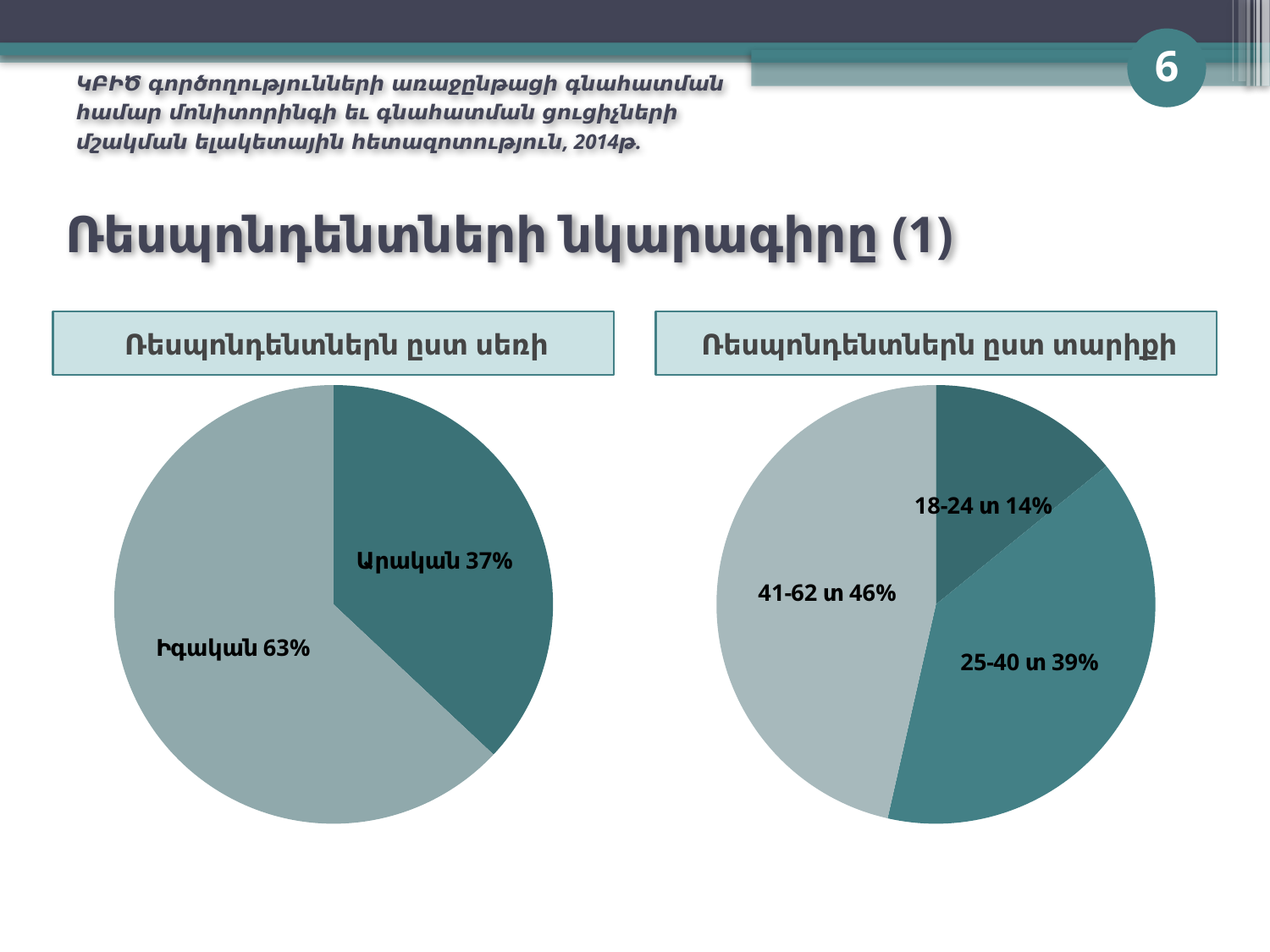
In the right chart (Ռեսպոնդենտներն ըստ տարիքի), which age group has the smallest share? 18-24 տ In the right chart (Ռեսպոնդենտներն ըստ տարիքի), what share is labelled for 18-24 տ? 14% In the left chart (Ռեսպոնդենտներն ըստ սեռի), what share is labelled for Իգական? 63% In the right chart (Ռեսպոնդենտներն ըստ տարիքի), which is larger: the share for 25-40 տ or for 41-62 տ? 41-62 տ In the left chart (Ռեսպոնդենտներն ըստ սեռի), which slice is the largest? Իգական What kind of chart is the left chart titled "Ռեսպոնդենտներն ըստ սեռի"? Pie chart In the right chart (Ռեսպոնդենտներն ըստ տարիքի), which age group has the largest share? 41-62 տ In the left chart (Ռեսպոնդենտներն ըստ սեռի), what share is labelled for Արական? 37% In the right chart (Ռեսպոնդենտներն ըստ տարիքի), what share is labelled for 25-40 տ? 39% In the left chart (Ռեսպոնդենտներն ըստ սեռի), what is the difference between the Իգական and Արական shares? 26% How many slices does the right pie chart (Ռեսպոնդենտներն ըստ տարիքի) have? 3 How many slices does the left pie chart (Ռեսպոնդենտներն ըստ սեռի) have? 2